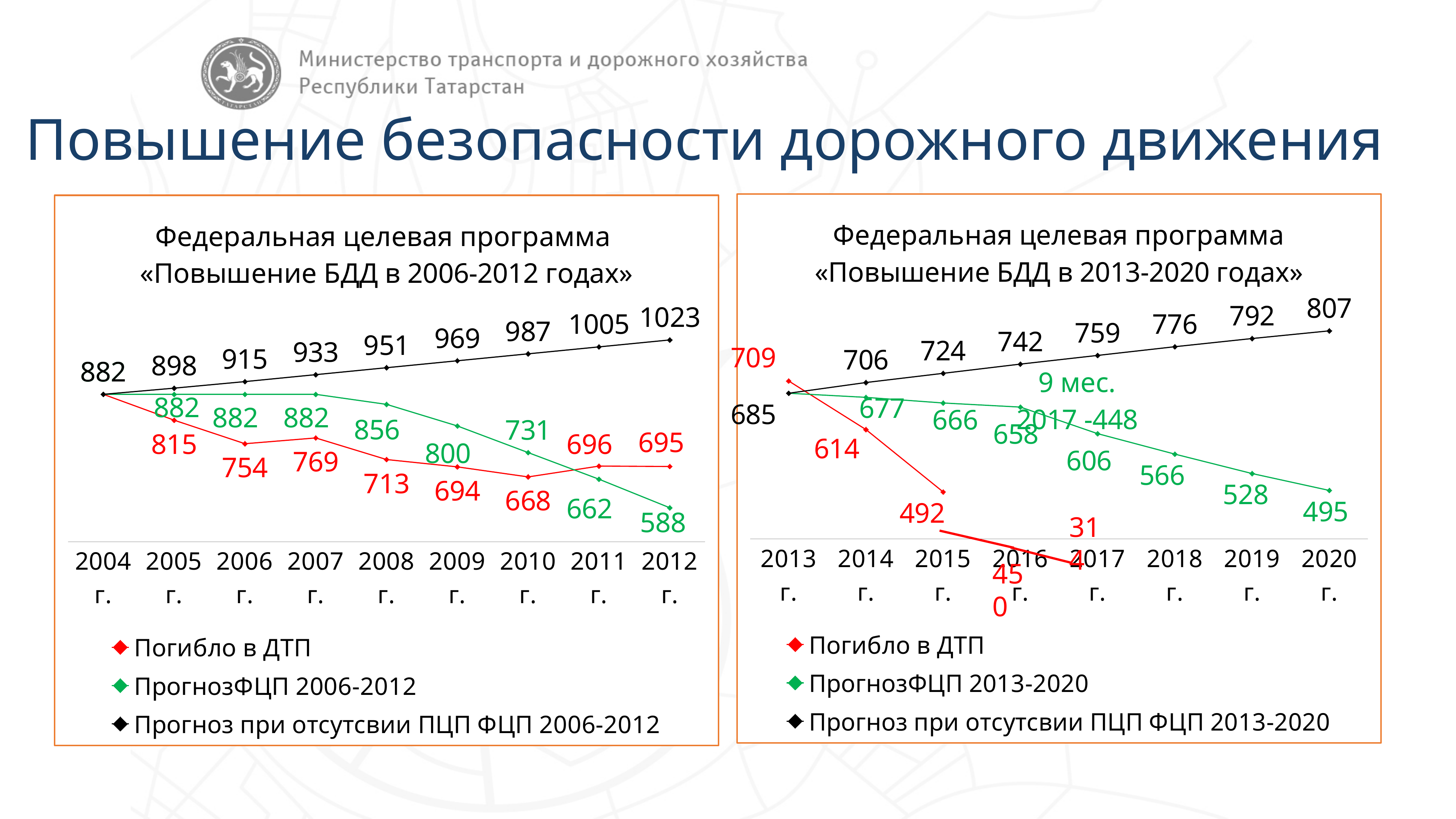
On the left chart (ФЦП 2006-2012), what is the value of «Погибло в ДТП» for 2004? 882 On the right chart (ФЦП 2013-2020), what is the value of «ПрогнозФЦП 2013-2020» for 2019? 528 On the left chart (ФЦП 2006-2012), what is the value of «Прогноз при отсутсвии ПЦП ФЦП 2006-2012» for 2012? 1023 On the right chart (ФЦП 2013-2020), what is the value of «Погибло в ДТП» for 2015? 492 On the right chart (ФЦП 2013-2020), what is the value of «Прогноз при отсутсвии ПЦП ФЦП 2013-2020» for 2020? 807 On the left chart (ФЦП 2006-2012), in which year is «Погибло в ДТП» lowest? 2010 On the left chart (ФЦП 2006-2012), what is the value of «ПрогнозФЦП 2006-2012» for 2010? 731 On the left chart (ФЦП 2006-2012), does «Прогноз при отсутсвии ПЦП ФЦП 2006-2012» rise or fall from 2004 to 2012? rise On the right chart (ФЦП 2013-2020), which is larger in 2014: «Погибло в ДТП» or «ПрогнозФЦП 2013-2020»? ПрогнозФЦП 2013-2020 How many series does the legend of the right chart (ФЦП 2013-2020) list? 3 On the left chart (ФЦП 2006-2012), what is the difference between «Прогноз при отсутсвии ПЦП ФЦП 2006-2012» and «ПрогнозФЦП 2006-2012» in 2012? 435 On the left chart (ФЦП 2006-2012), how many years are shown on the x axis? 9